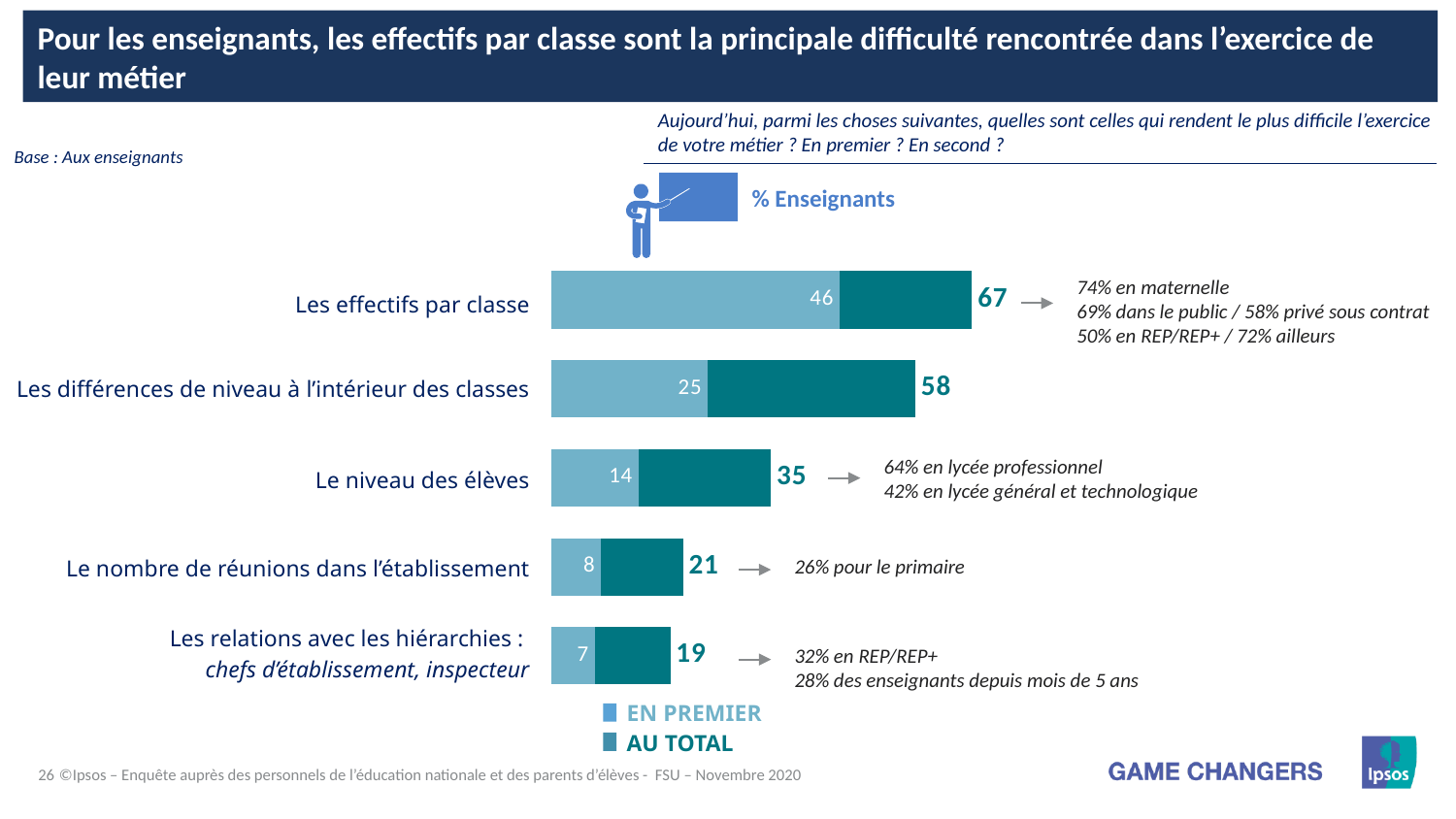
How many series does the legend list? 2 What kind of chart is shown on the slide? Bar chart Which is larger: the 'EN PREMIER' value for 'Le niveau des élèves' or for 'Le nombre de réunions dans l'établissement'? Le niveau des élèves What is the 'AU TOTAL' value for 'Le niveau des élèves'? 35 How many categories are shown in the chart? 5 What is the 'AU TOTAL' value for 'Les effectifs par classe'? 67 Which category has the highest 'AU TOTAL' value? Les effectifs par classe Which category has the lowest 'EN PREMIER' value? Les relations avec les hiérarchies : chefs d'établissement, inspecteur What is the 'EN PREMIER' value for 'Le nombre de réunions dans l'établissement'? 8 What are the two series named in the legend? EN PREMIER and AU TOTAL What is the 'EN PREMIER' value for 'Les différences de niveau à l'intérieur des classes'? 25 What is the difference between the 'AU TOTAL' values for 'Les effectifs par classe' and 'Les différences de niveau à l'intérieur des classes'? 9